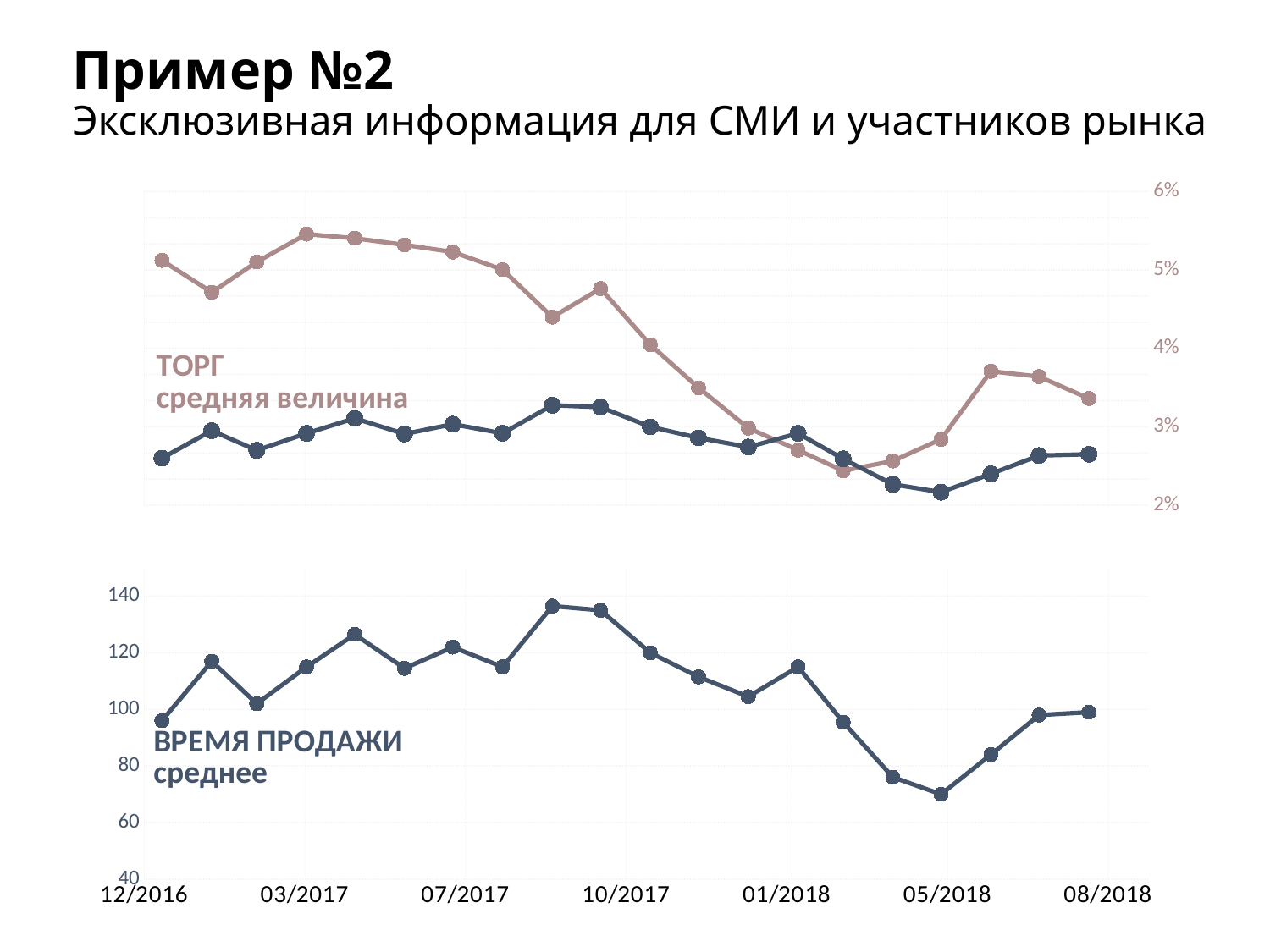
In the bottom chart (ВРЕМЯ ПРОДАЖИ среднее), which is larger: the value for 03/2017 or the value for 05/2018? 03/2017 In the bottom chart (ВРЕМЯ ПРОДАЖИ среднее), is the value for 05/2018 greater or less than 80? less In the top chart, is the ТОРГ средняя величина value for 05/2018 greater or less than 3%? less What kind of chart is the bottom chart titled ВРЕМЯ ПРОДАЖИ среднее? line chart In the bottom chart (ВРЕМЯ ПРОДАЖИ среднее), which labelled month has the lowest value? 05/2018 In the top chart, is the ТОРГ средняя величина value for 12/2016 greater or less than 5%? greater In the top chart, does the ТОРГ средняя величина line overall rise or fall from 12/2016 to 08/2018? fall In the top chart, which is larger at 12/2016: the ТОРГ средняя величина line or the dark blue line? ТОРГ средняя величина How many lines are plotted in the top chart? 2